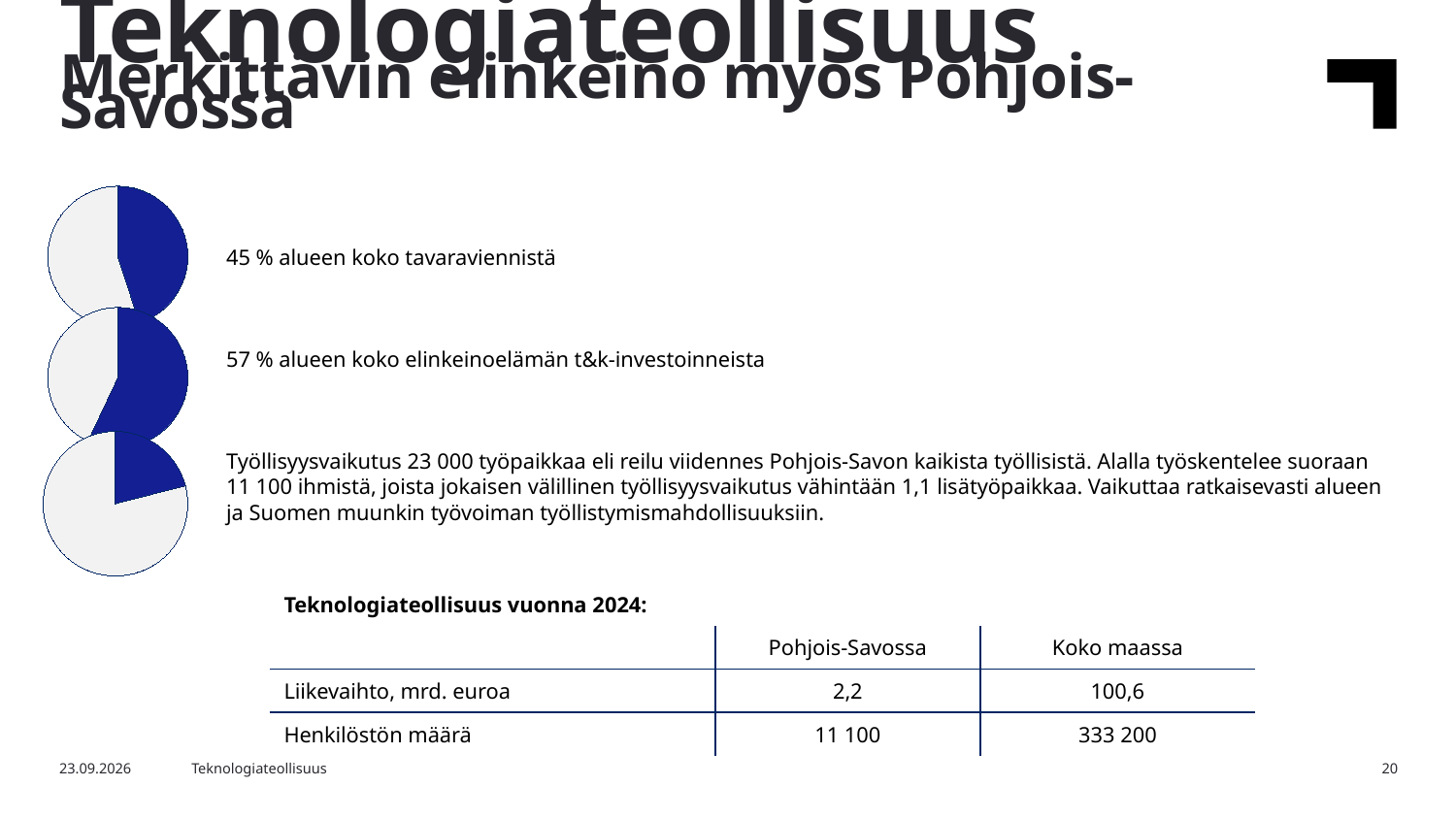
How many slices does each pie chart on the left have? 2 According to the text next to the top pie chart, what share of the region's total goods exports does the highlighted slice represent? 45 % What colour is the highlighted slice in the pie charts? Dark blue Is the highlighted slice in the bottom pie chart more or less than half of the pie? Less Which of the three pie charts on the left has the largest highlighted (blue) slice? The middle pie chart What is the difference in percentage points between the shares shown for the middle pie chart (57 %) and the top pie chart (45 %)? 12 percentage points What kind of charts are shown on the left side of the slide? Pie charts According to the text next to the middle pie chart, what share of the region's business R&D investments does the highlighted slice represent? 57 % Is the highlighted slice larger in the top pie chart or in the middle pie chart? The middle pie chart What does the top pie chart's highlighted slice represent, according to the text beside it? 45 % alueen koko tavaraviennistä How many pie charts are on the slide? 3 Which of the three pie charts on the left has the smallest highlighted (blue) slice? The bottom pie chart